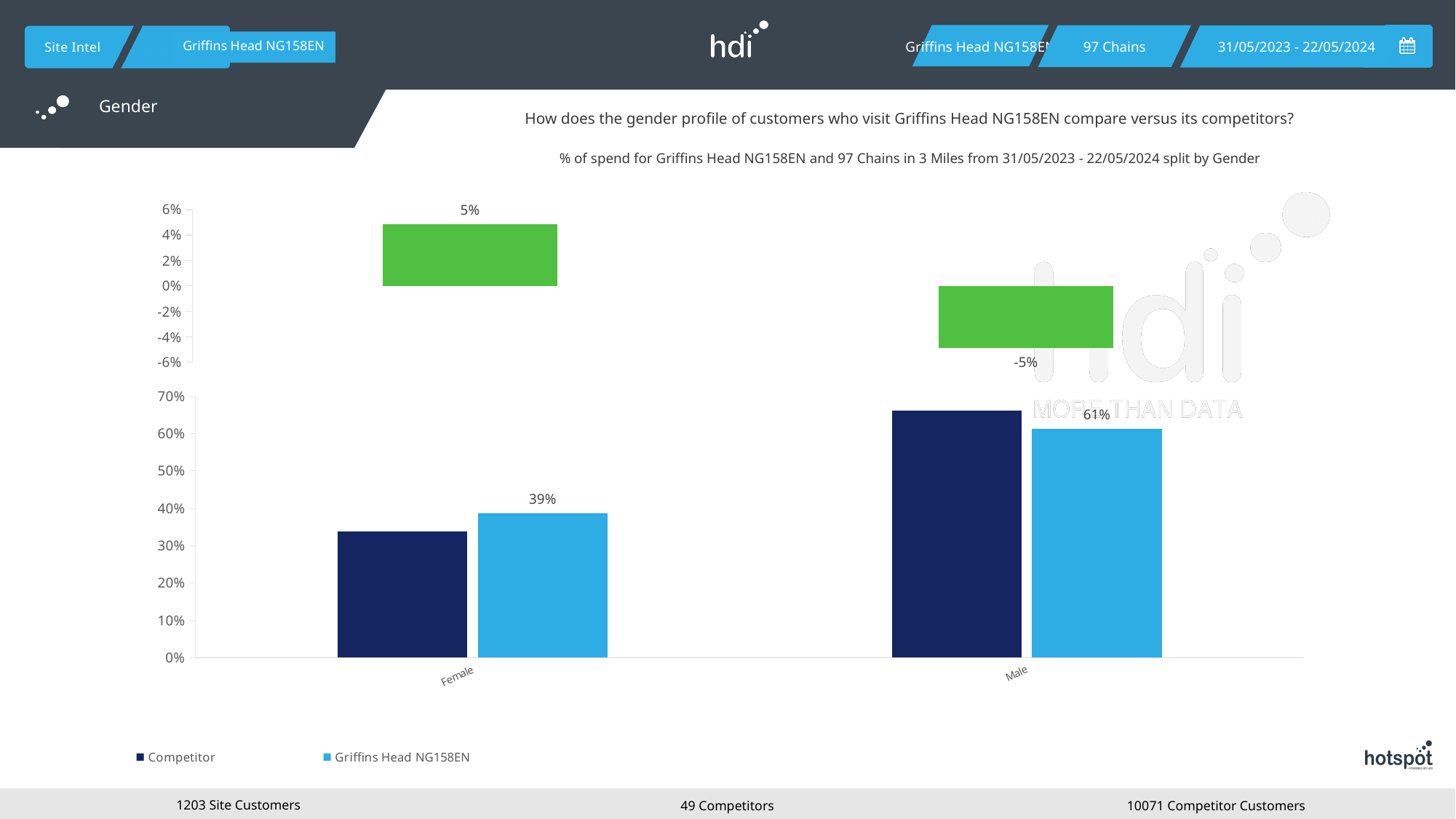
What type of chart is the lower chart on the slide? Bar chart In the lower bar chart, is the Competitor value for Male greater or less than 60%? greater In the lower bar chart, which category has the higher value for Griffins Head NG158EN, Female or Male? Male How many categories are shown on the x axis of the lower bar chart? 2 In the lower bar chart, which is larger in the Male category, the Competitor bar or the Griffins Head NG158EN bar? Competitor In the lower bar chart, what is the difference between the Griffins Head NG158EN values for Male and Female? 22% In the lower bar chart, what is the value for Griffins Head NG158EN in the Male category? 61% In the lower bar chart, is the Competitor value for Female greater or less than 40%? less In the lower bar chart, what is the value for Griffins Head NG158EN in the Female category? 39% In the upper green difference chart, what is the value shown for Male? -5% In the upper green difference chart, what is the value shown for Female? 5% How many series does the legend of the lower bar chart list? 2